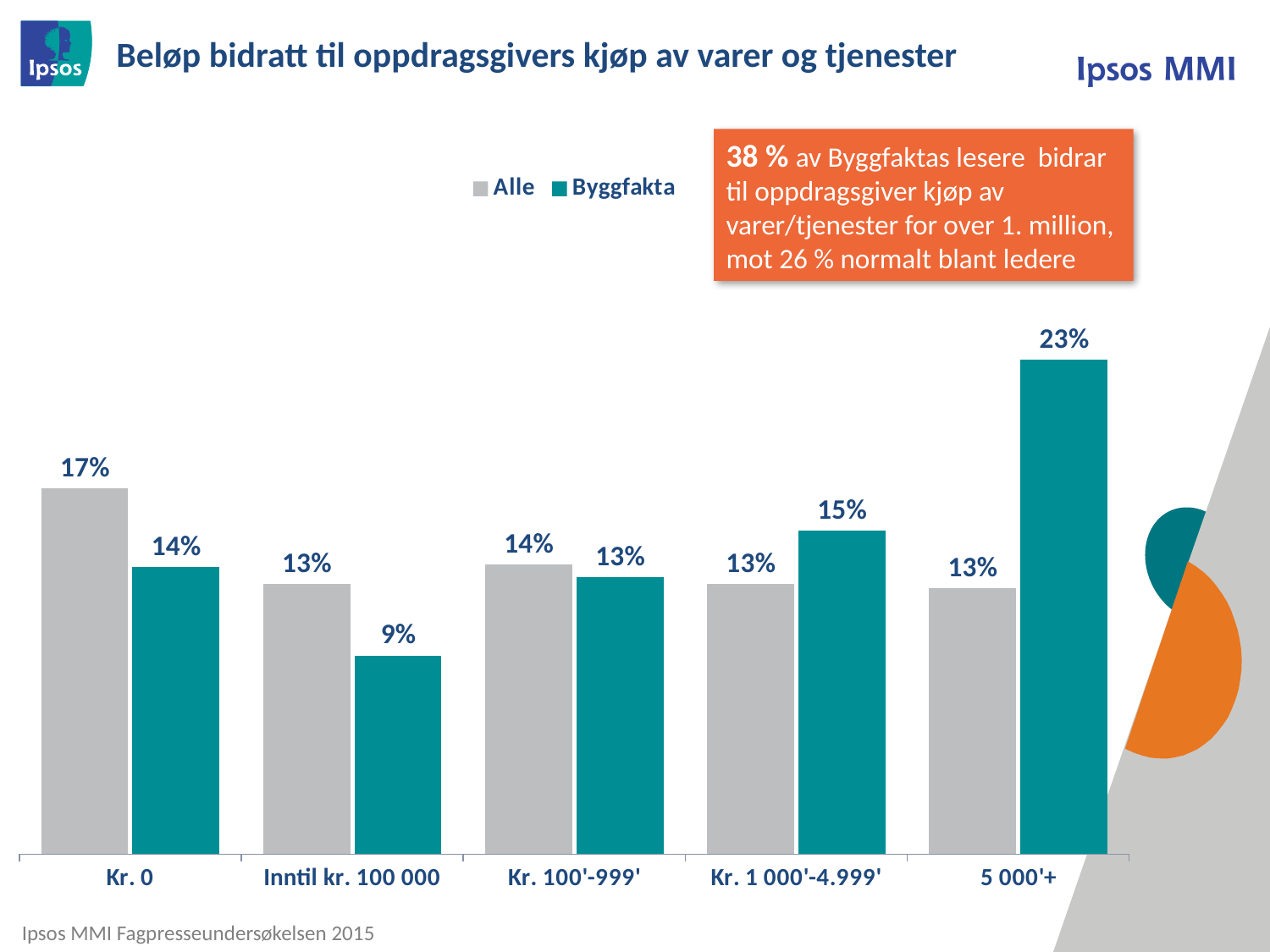
What is the difference between the Byggfakta and Alle values in the 5 000'+ category? 10% How many series does the legend list? 2 What is the value for Byggfakta in the 5 000'+ category? 23% Which category has the highest Alle value? Kr. 0 How many categories are shown on the x axis? 5 Which category has the lowest Byggfakta value? Inntil kr. 100 000 What is the value for Alle in the Kr. 1 000'-4.999' category? 13% What kind of chart is shown on the slide? Bar chart Which category has the highest Byggfakta value? 5 000'+ What is the value for Byggfakta in the Inntil kr. 100 000 category? 9% In the Kr. 0 category, which series has the larger value, Alle or Byggfakta? Alle What is the value for Alle in the Kr. 0 category? 17%